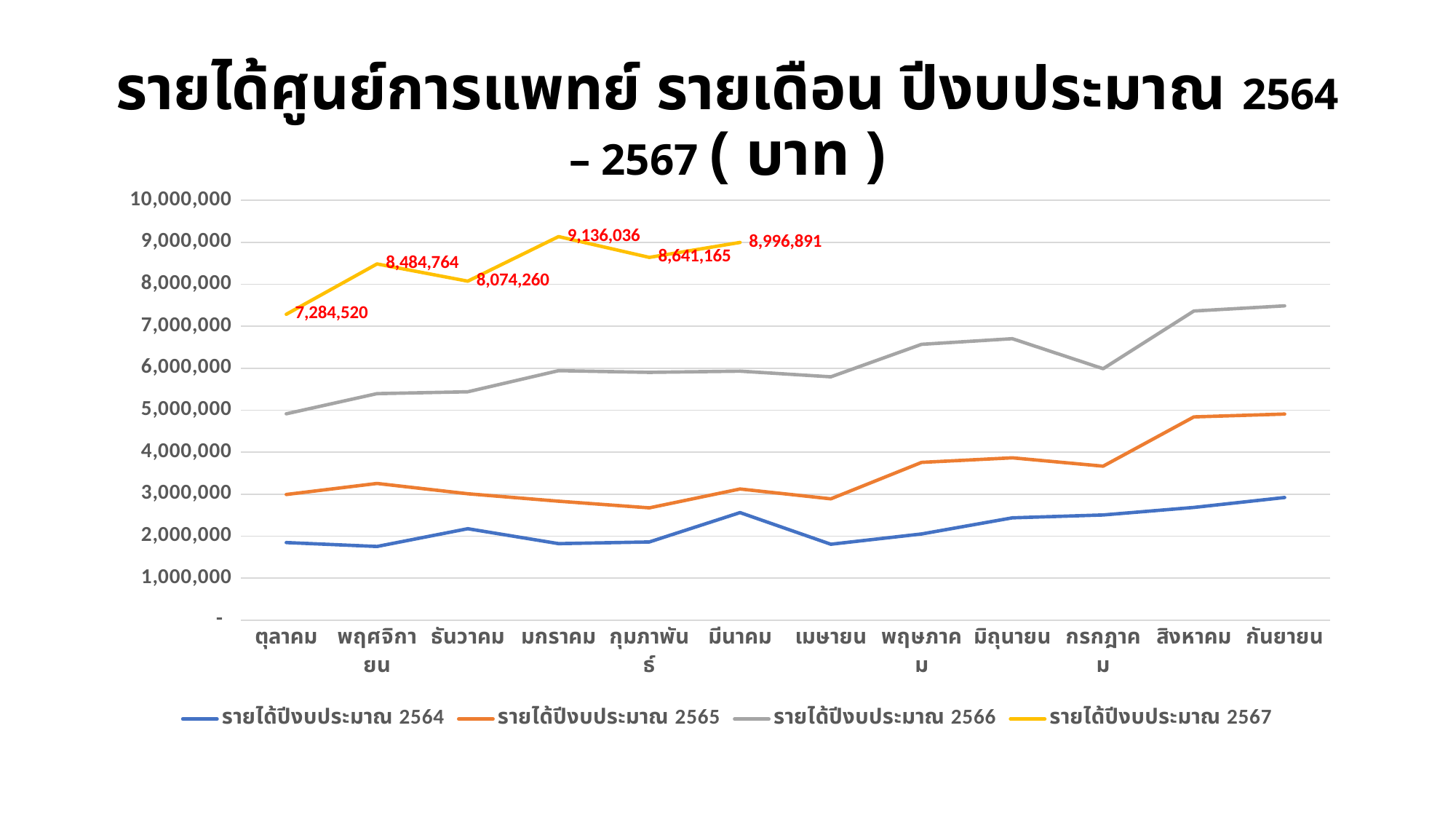
How many series does the legend list? 4 What is the value for รายได้ปีงบประมาณ 2567 in ตุลาคม? 7,284,520 What is the value for รายได้ปีงบประมาณ 2567 in มกราคม? 9,136,036 What is the difference between the รายได้ปีงบประมาณ 2567 values for มกราคม and กุมภาพันธ์? 494,871 What is the value for รายได้ปีงบประมาณ 2567 in มีนาคม? 8,996,891 Which series is drawn in yellow? รายได้ปีงบประมาณ 2567 In which month is the value for รายได้ปีงบประมาณ 2567 highest? มกราคม Is the value for รายได้ปีงบประมาณ 2566 in กันยายน greater or less than 7,000,000? greater What kind of chart is shown on the slide? line chart Which is larger for รายได้ปีงบประมาณ 2567: พฤศจิกายน or ธันวาคม? พฤศจิกายน In which month is the value for รายได้ปีงบประมาณ 2567 lowest? ตุลาคม How many months are shown on the x axis? 12